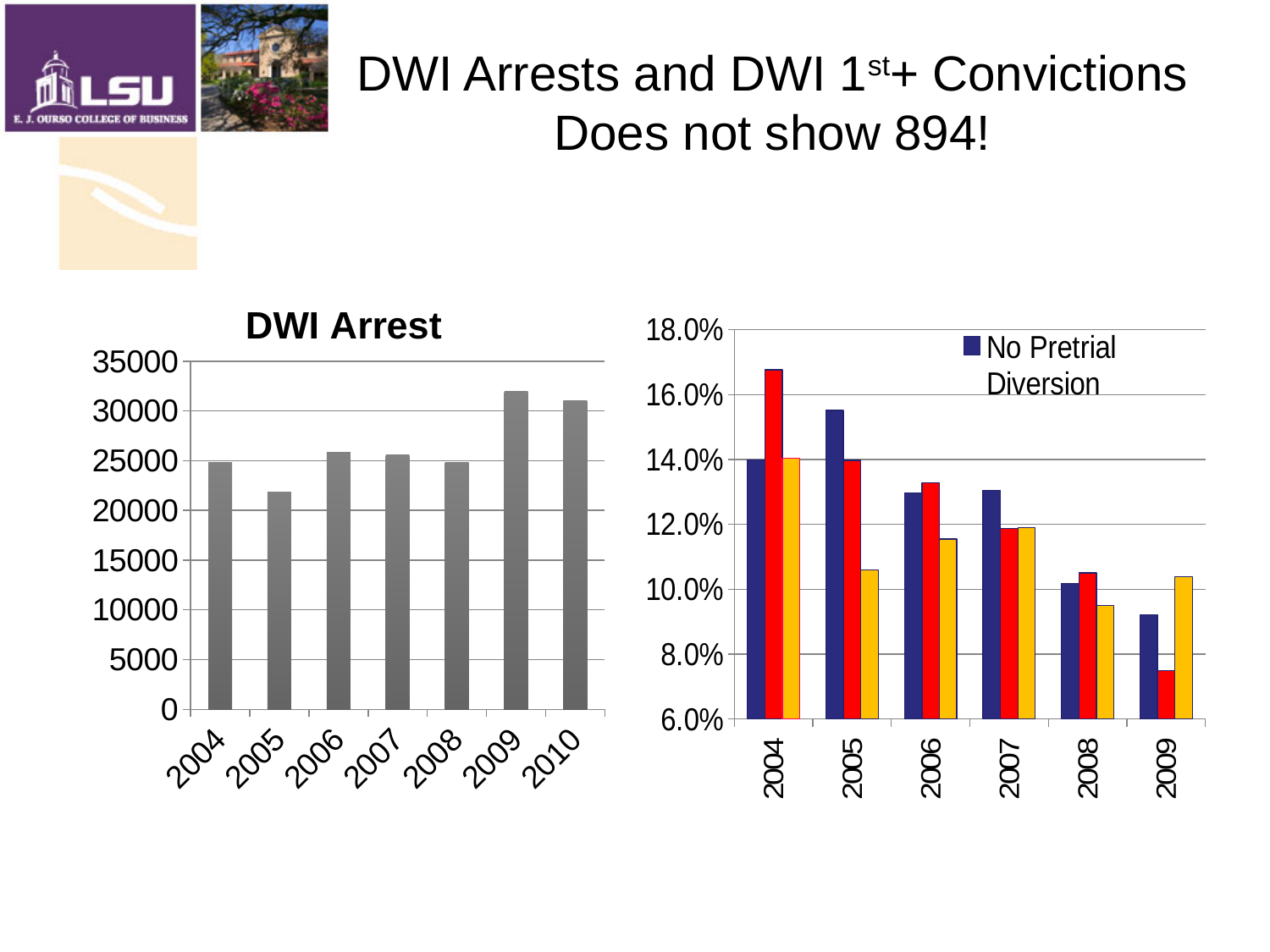
In the chart on the right, is the red bar for 2004 greater or less than 16.0%? greater In the 'DWI Arrest' chart on the left, which year has the highest number of arrests? 2009 In the chart on the right, for 2009, is the red bar or the yellow bar larger? yellow In the 'DWI Arrest' chart on the left, which year has the lowest number of arrests? 2005 In the 'DWI Arrest' chart on the left, is the value for 2009 greater or less than 30000? greater In the chart on the right, which year has the highest value for the 'No Pretrial Diversion' (blue) series? 2005 What kind of chart is the 'DWI Arrest' chart on the left? bar chart How many years are shown on the x axis of the 'DWI Arrest' chart on the left? 7 In the 'DWI Arrest' chart on the left, is the value for 2005 greater or less than 25000? less In the chart on the right, which year has the lowest value for the 'No Pretrial Diversion' (blue) series? 2009 In the chart on the right, does the 'No Pretrial Diversion' (blue) series generally rise or fall from 2005 to 2009? fall